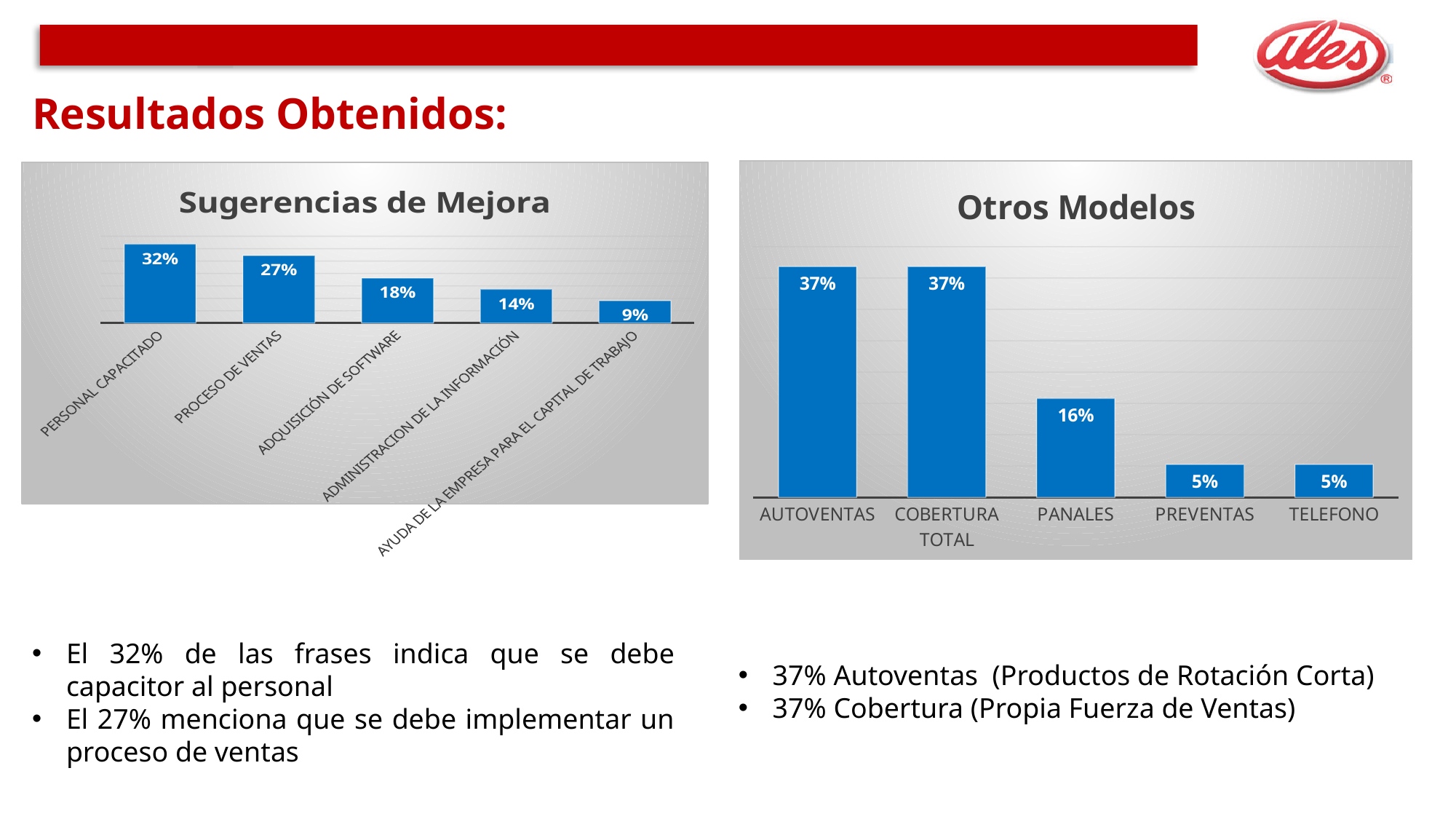
In the 'Otros Modelos' chart, what is the value for TELEFONO? 5% What kind of chart is 'Otros Modelos'? bar chart In the 'Sugerencias de Mejora' chart, which category has the lowest value? AYUDA DE LA EMPRESA PARA EL CAPITAL DE TRABAJO In the 'Sugerencias de Mejora' chart, which category has the highest value? PERSONAL CAPACITADO In the 'Sugerencias de Mejora' chart, how many categories are shown? 5 In the 'Otros Modelos' chart, which is larger, PANALES or PREVENTAS? PANALES In the 'Sugerencias de Mejora' chart, what is the difference between PERSONAL CAPACITADO and ADQUISICIÓN DE SOFTWARE? 14% What is the title of the chart on the left side of the slide? Sugerencias de Mejora In the 'Otros Modelos' chart, what is the value for PANALES? 16% In the 'Sugerencias de Mejora' chart, do the values rise or fall from left to right? fall In the 'Sugerencias de Mejora' chart, what is the value for PROCESO DE VENTAS? 27% In the 'Otros Modelos' chart, what is the difference between AUTOVENTAS and PANALES? 21%